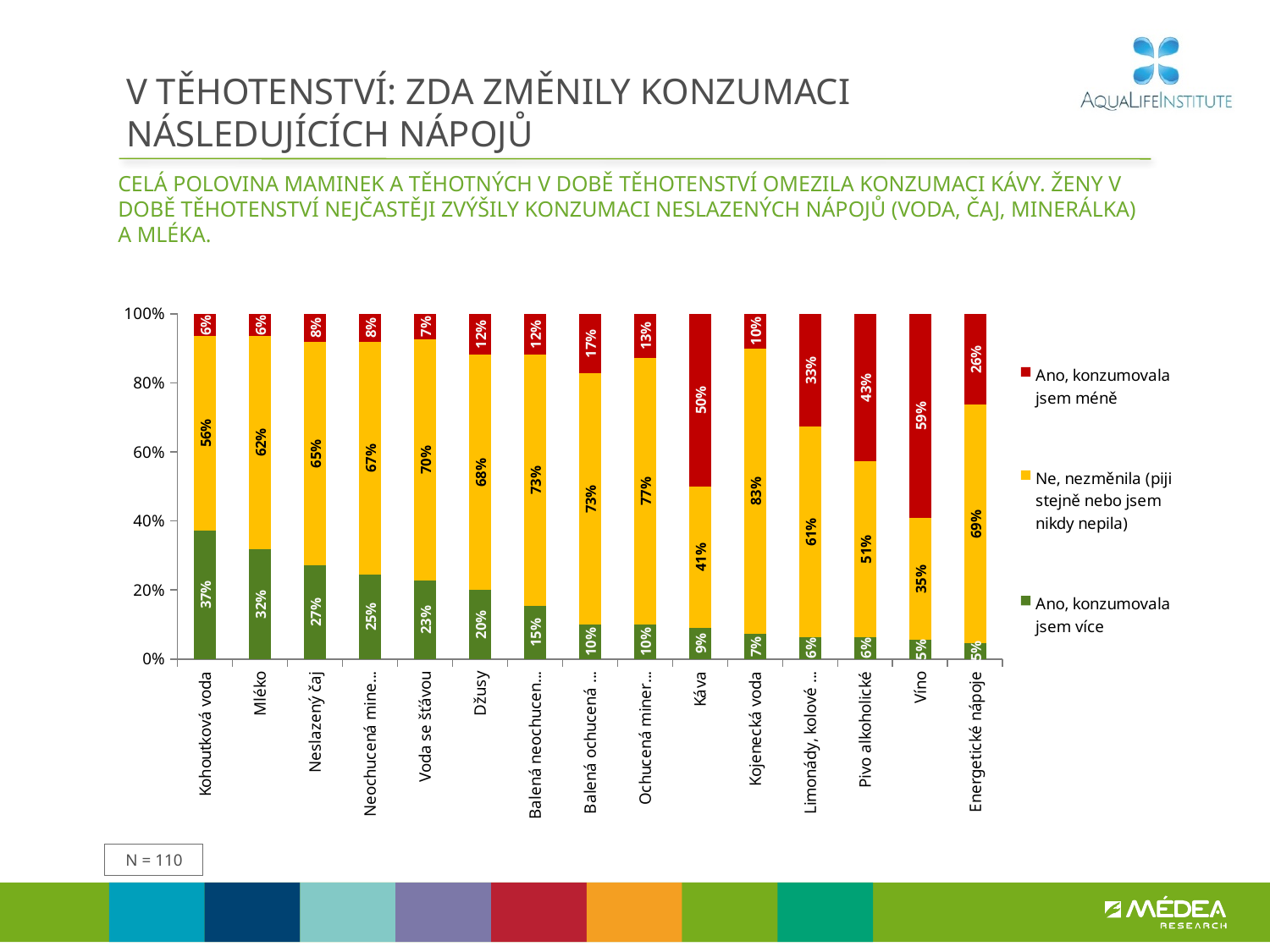
How many drink categories are shown on the x axis of the chart? 15 What percentage of respondents said they consumed more ("Ano, konzumovala jsem více") tap water (Kohoutková voda) during pregnancy? 37% Which is larger: the "Ano, konzumovala jsem více" value for Mléko or for Džusy? Mléko How many series does the chart legend list? 3 What sample size (N) is stated on the slide? N = 110 What is the value of "Ne, nezměnila (piji stejně nebo jsem nikdy nepila)" for Kojenecká voda? 83% What is the difference between the "Ano, konzumovala jsem méně" values for Víno and Pivo alkoholické? 16% Which category has the highest value for "Ano, konzumovala jsem více"? Kohoutková voda What is the value of "Ano, konzumovala jsem méně" for Káva? 50% Which category has the highest value for "Ano, konzumovala jsem méně"? Víno What is the value of "Ne, nezměnila (piji stejně nebo jsem nikdy nepila)" for Energetické nápoje? 69% What type of chart is shown on the slide? Stacked bar chart